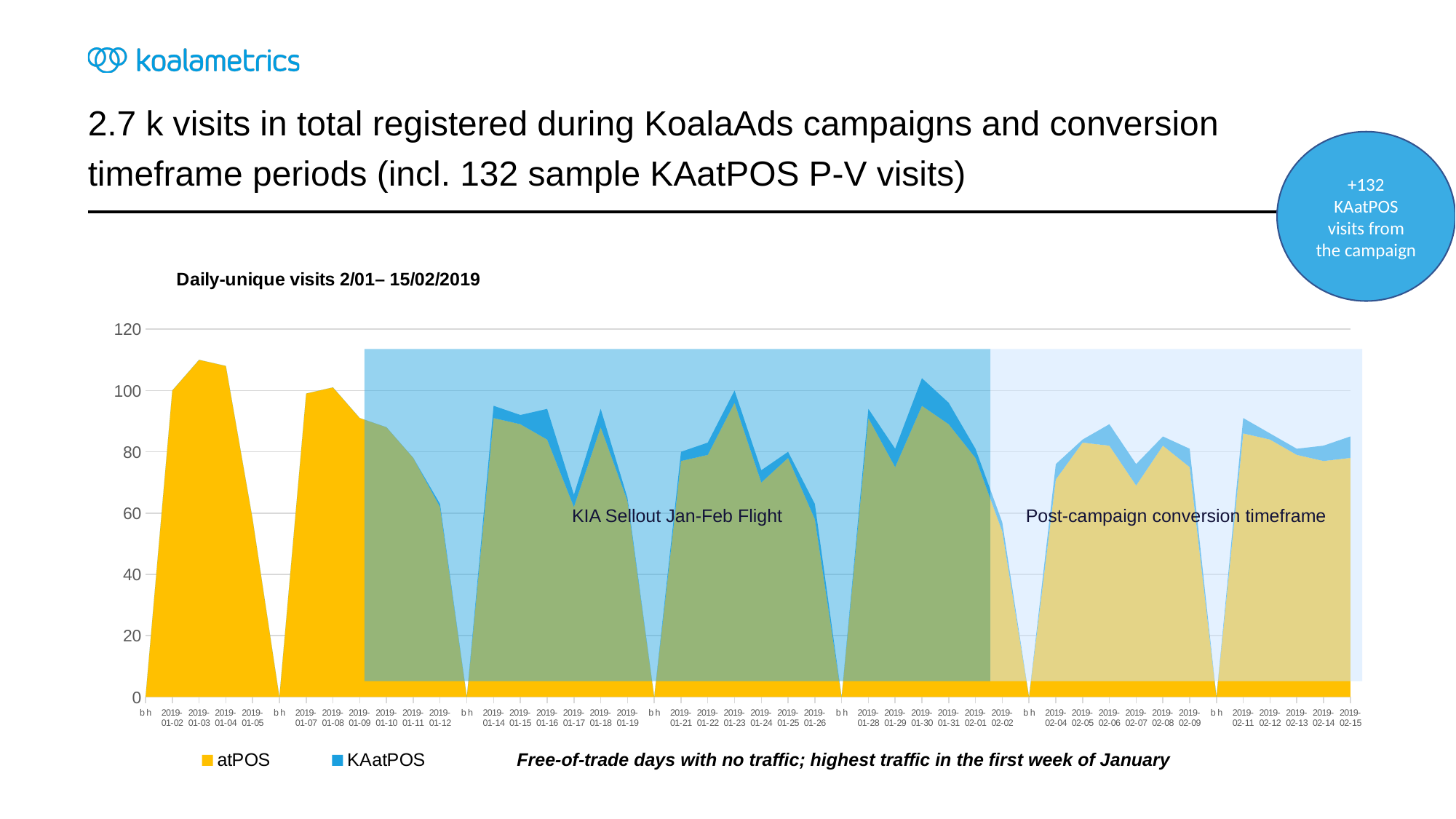
Is the total value for 2019-01-17 greater or less than 80? less What kind of chart is shown on the slide? Area chart Which date has the higher value, 2019-01-03 or 2019-01-08? 2019-01-03 Is the total value for 2019-02-07 greater or less than 80? less How many series does the chart legend list? 2 What are the two series named in the chart legend? atPOS and KAatPOS Is the value for 2019-01-09 greater or less than 80? greater Which date has the higher total value, 2019-01-17 or 2019-01-18? 2019-01-18 On which date does the chart reach its highest daily value? 2019-01-03 What is the title of the chart? Daily-unique visits 2/01– 15/02/2019